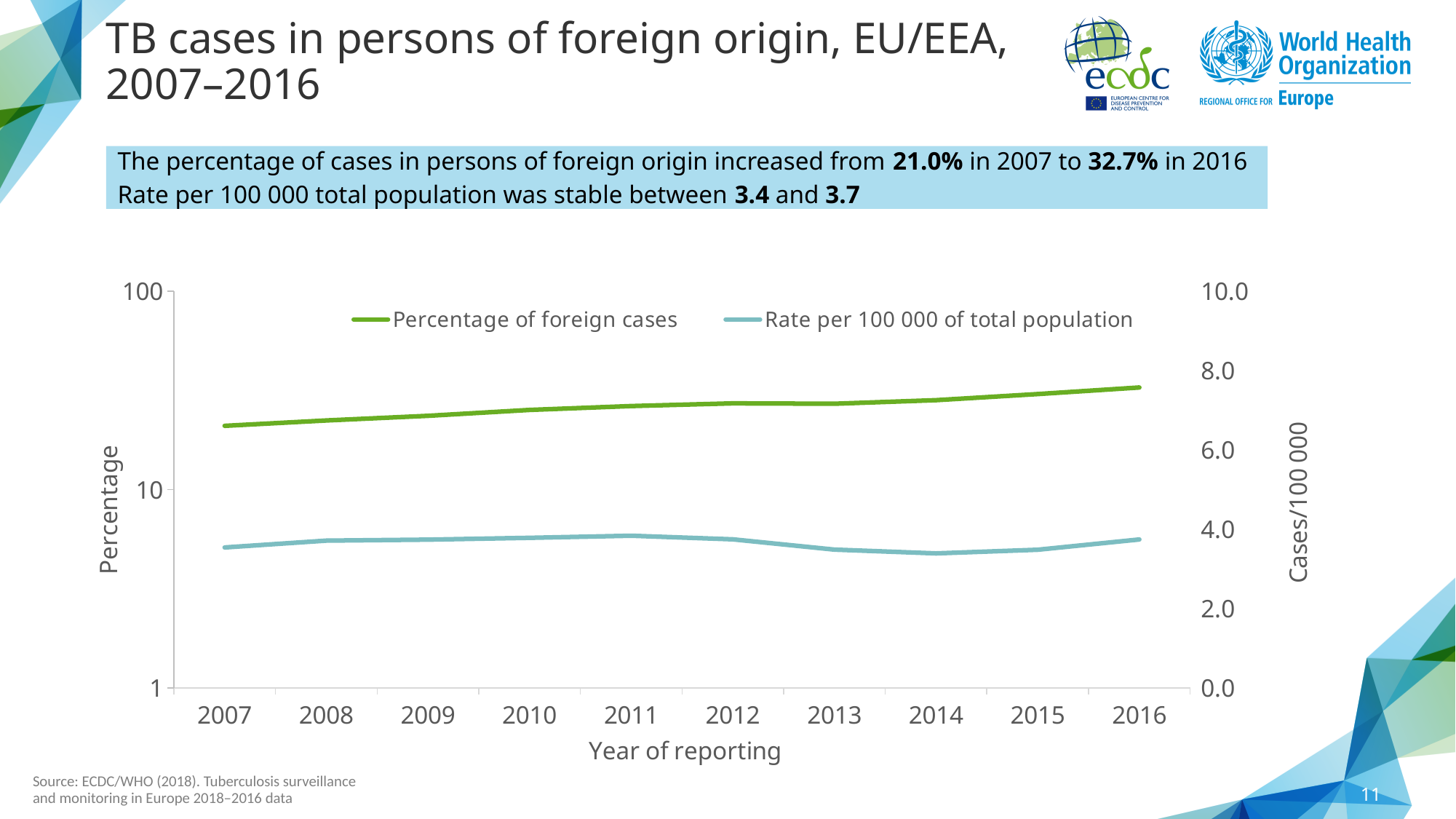
Does the percentage of foreign cases rise or fall from 2007 to 2016? Rise How many years are plotted along the x axis of the chart? 10 What is the title of the x axis of the chart? Year of reporting What was the percentage of cases in persons of foreign origin in 2007? 21.0% What kind of chart is shown on the slide? Line chart In which year is the percentage of foreign cases highest? 2016 What was the percentage of cases in persons of foreign origin in 2016? 32.7% Is the percentage of foreign cases in 2016 greater or less than 10? greater By how many percentage points did the percentage of foreign cases increase from 2007 to 2016? 11.7 percentage points In which year is the percentage of foreign cases lowest? 2007 Is the rate per 100 000 of total population in 2014 greater or less than 4.0? less How many series does the chart legend list? 2